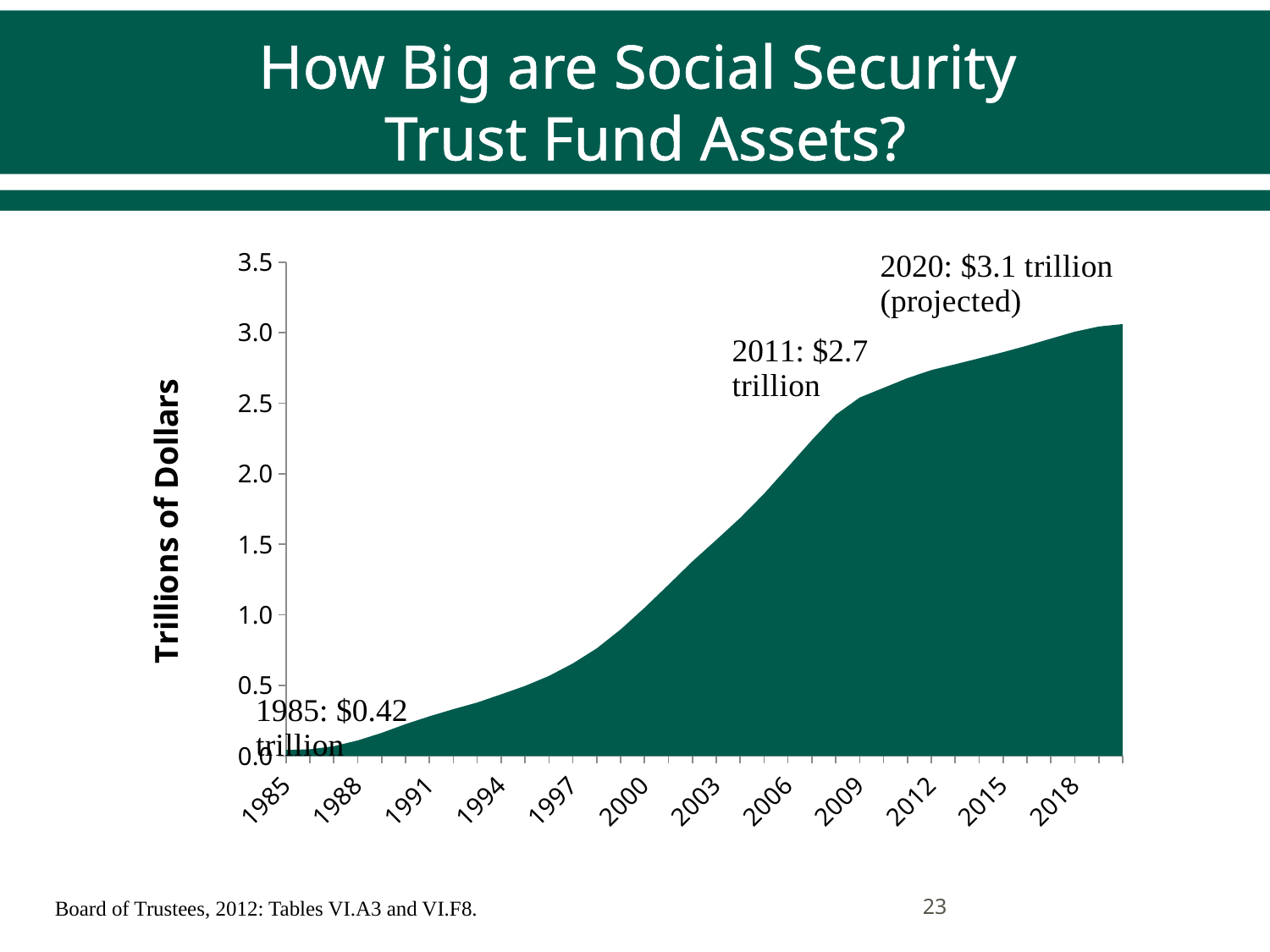
What is the projected value of trust fund assets for 2020 according to the chart? $3.1 trillion What kind of chart is shown on the slide? Area chart What value does the chart give for trust fund assets in 2011? $2.7 trillion What value does the chart give for Social Security trust fund assets in 1985? $0.42 trillion What is the label on the vertical axis of the chart? Trillions of Dollars By how much do trust fund assets grow between 2011 and the projected 2020 value? $0.4 trillion What is the difference between the 2011 value and the 1985 value of trust fund assets? $2.28 trillion Which is larger, the trust fund assets in 1985 or in 2011? 2011 Do trust fund assets rise or fall from 1985 to 2020 on the chart? Rise Is the value for 1991 greater or less than 0.5 trillion dollars? less Is the value for 2009 greater or less than 2.0 trillion dollars? greater Is the value for 2003 greater or less than 1.0 trillion dollars? greater